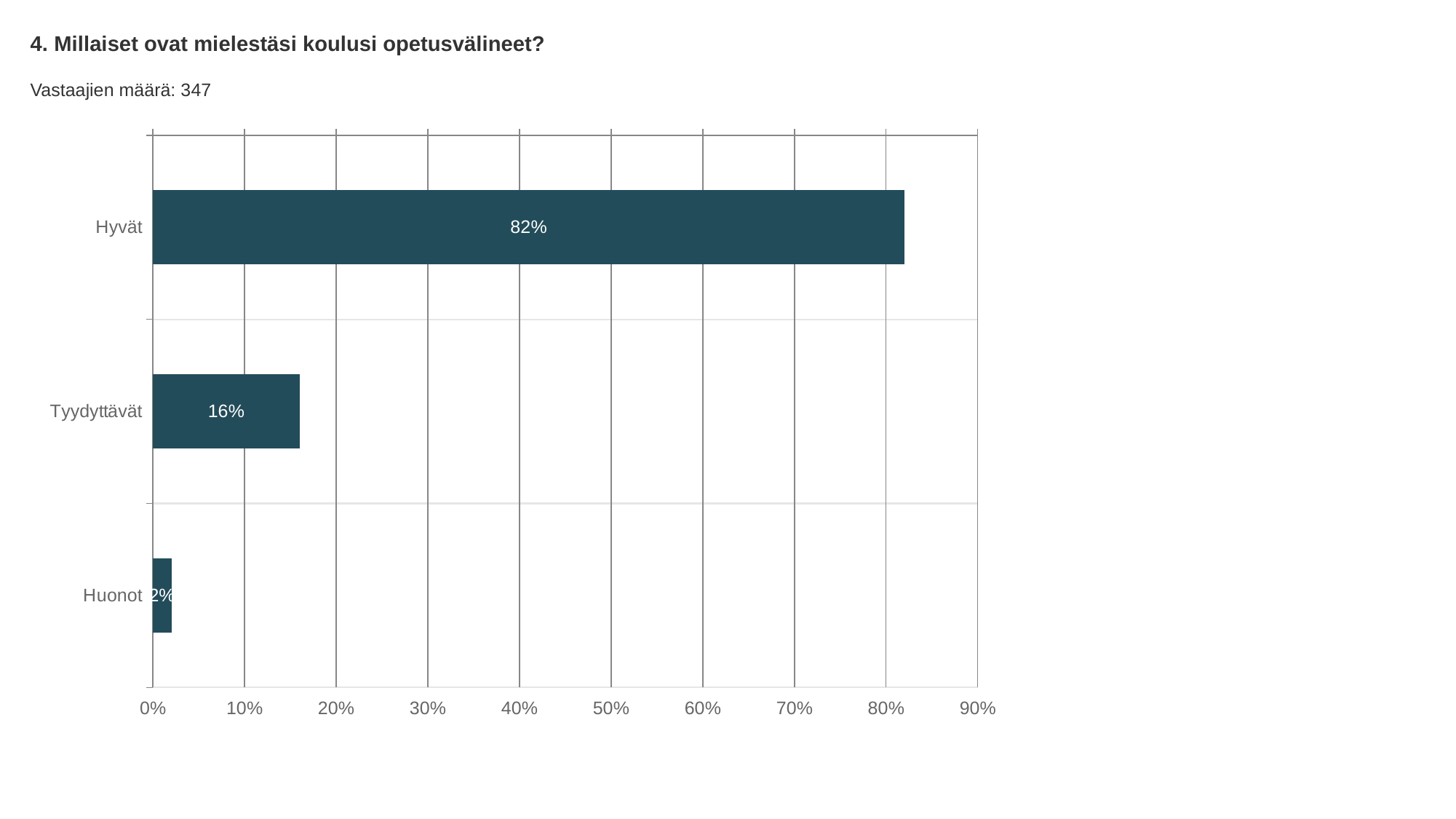
What kind of chart is shown on the slide? bar chart Which is larger, the value for Tyydyttävät or the value for Huonot? Tyydyttävät Which category has the highest value? Hyvät What is the value for Tyydyttävät? 16% Which category has the lowest value? Huonot Is the value for Hyvät greater or less than 50%? greater What is the value for Hyvät? 82% What is the difference between the values for Hyvät and Tyydyttävät? 66% What is the difference between the values for Tyydyttävät and Huonot? 14% What is the value for Huonot? 2% How many respondents (Vastaajien määrä) are reported on the slide? 347 How many categories are shown in the chart? 3